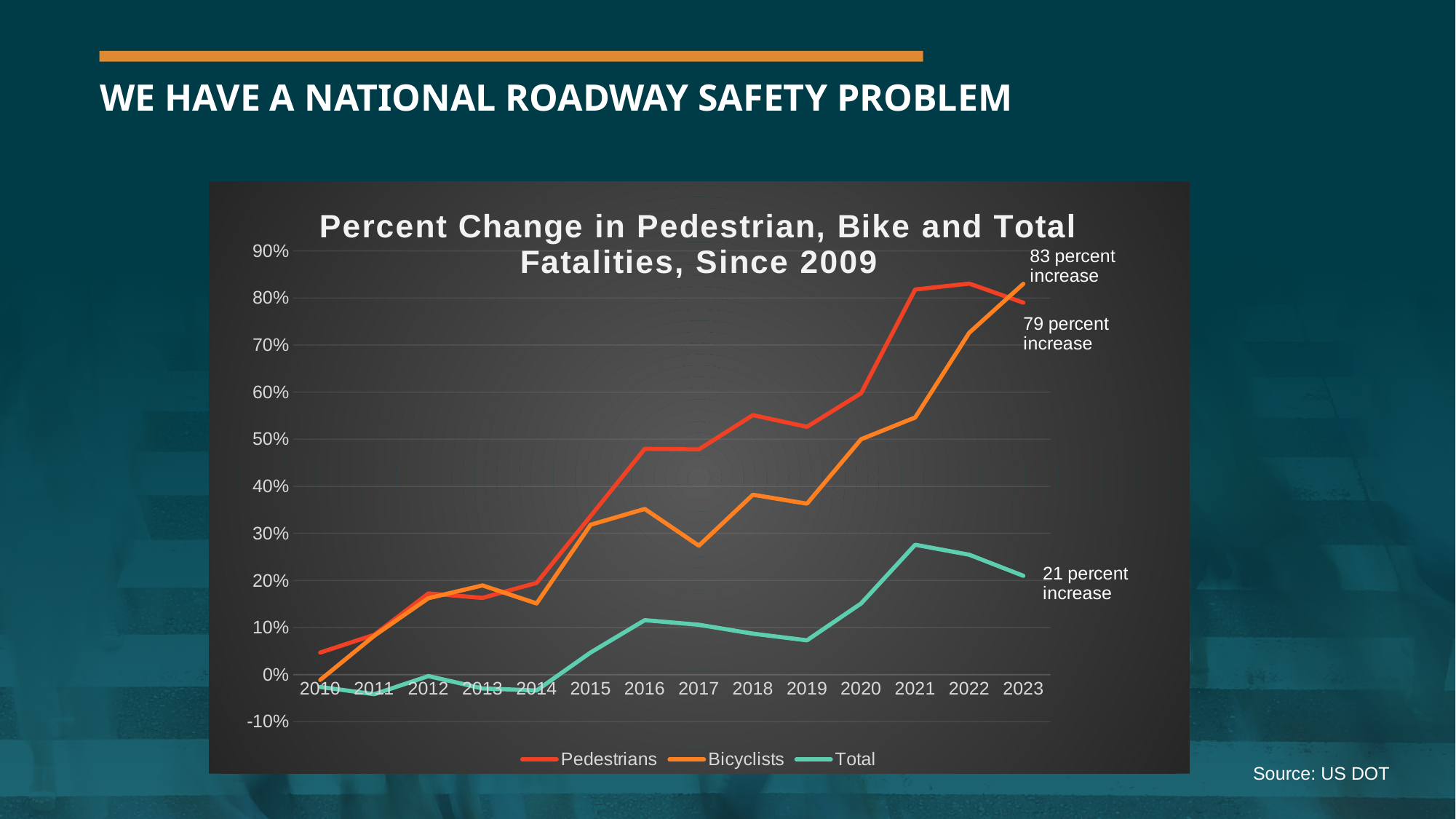
Is the value for Total in 2021 greater or less than 20%? greater According to the annotation, what is the percent change in pedestrian fatalities in 2023? 79 percent increase What is the title of the chart? Percent Change in Pedestrian, Bike and Total Fatalities, Since 2009 By how many percentage points does the 2023 bicyclist increase exceed the 2023 pedestrian increase? 4 How many series does the chart's legend list? 3 Does the Total line rise or fall from 2021 to 2023? Fall According to the annotation, what is the percent change in bicyclist fatalities in 2023? 83 percent increase What kind of chart is shown on the slide? Line chart How many years are plotted along the x axis of the chart? 14 According to the annotation, what is the percent change in total fatalities in 2023? 21 percent increase Is the value for Pedestrians in 2016 greater or less than 40%? greater Which series has the lowest value in 2023? Total